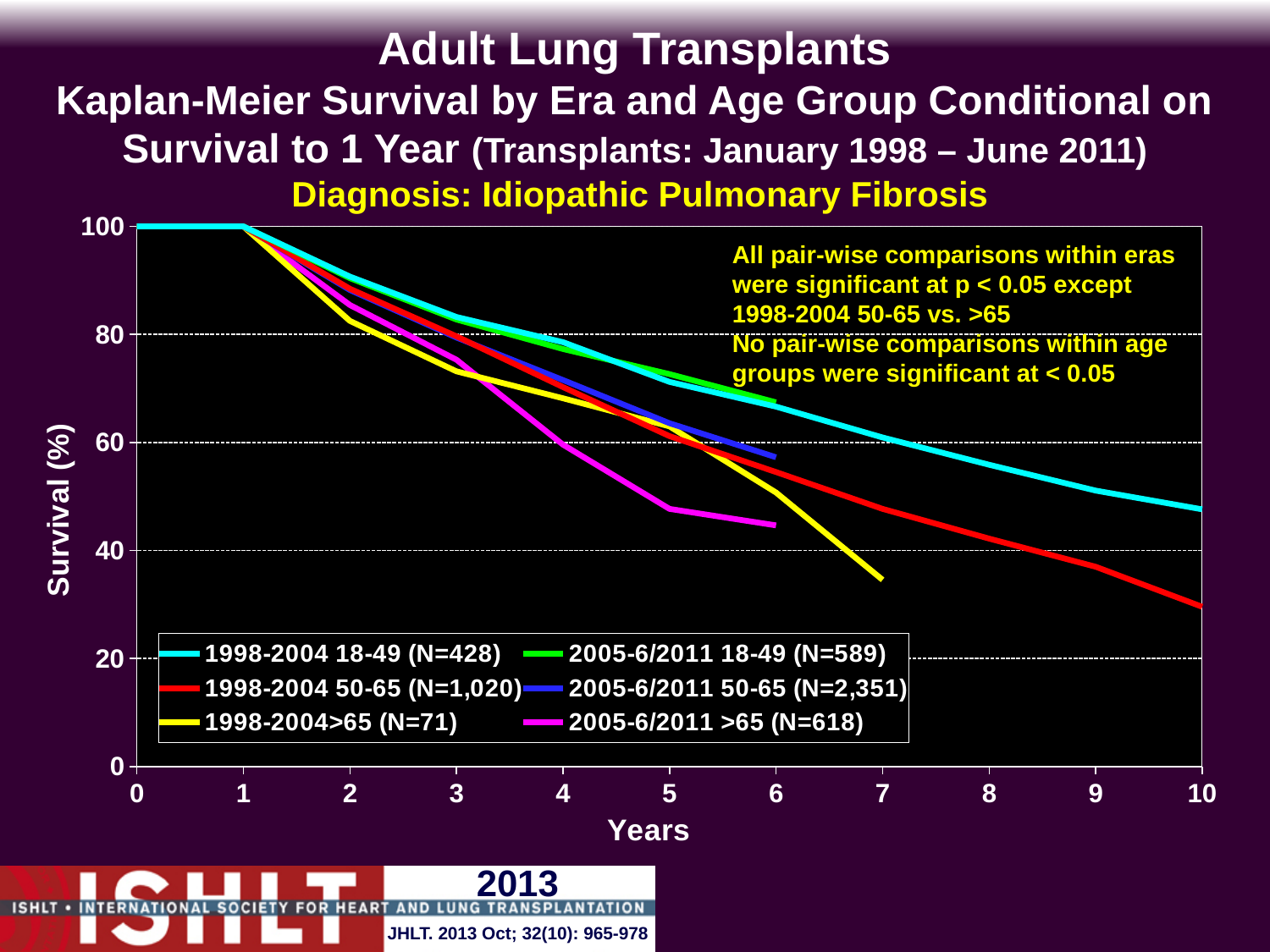
Which group has the lowest survival at year 4? 2005-6/2011 >65 Is the survival value for the 1998-2004 18-49 group at year 10 greater or less than 40? greater At year 6, which group has higher survival: 2005-6/2011 50-65 or 2005-6/2011 >65? 2005-6/2011 50-65 Is the survival value for the 2005-6/2011 50-65 group at year 6 greater or less than 60? less How many series does the legend list? 6 Do the survival curves rise or fall as years increase? Fall What is the N for the 2005-6/2011 50-65 group shown in the legend? N=2,351 What diagnosis is stated in the chart title? Idiopathic Pulmonary Fibrosis At year 10, which group has higher survival: 1998-2004 18-49 or 1998-2004 50-65? 1998-2004 18-49 Is the survival value for the 1998-2004 >65 group at year 7 greater or less than 40? less What kind of chart is shown on the slide? Line chart